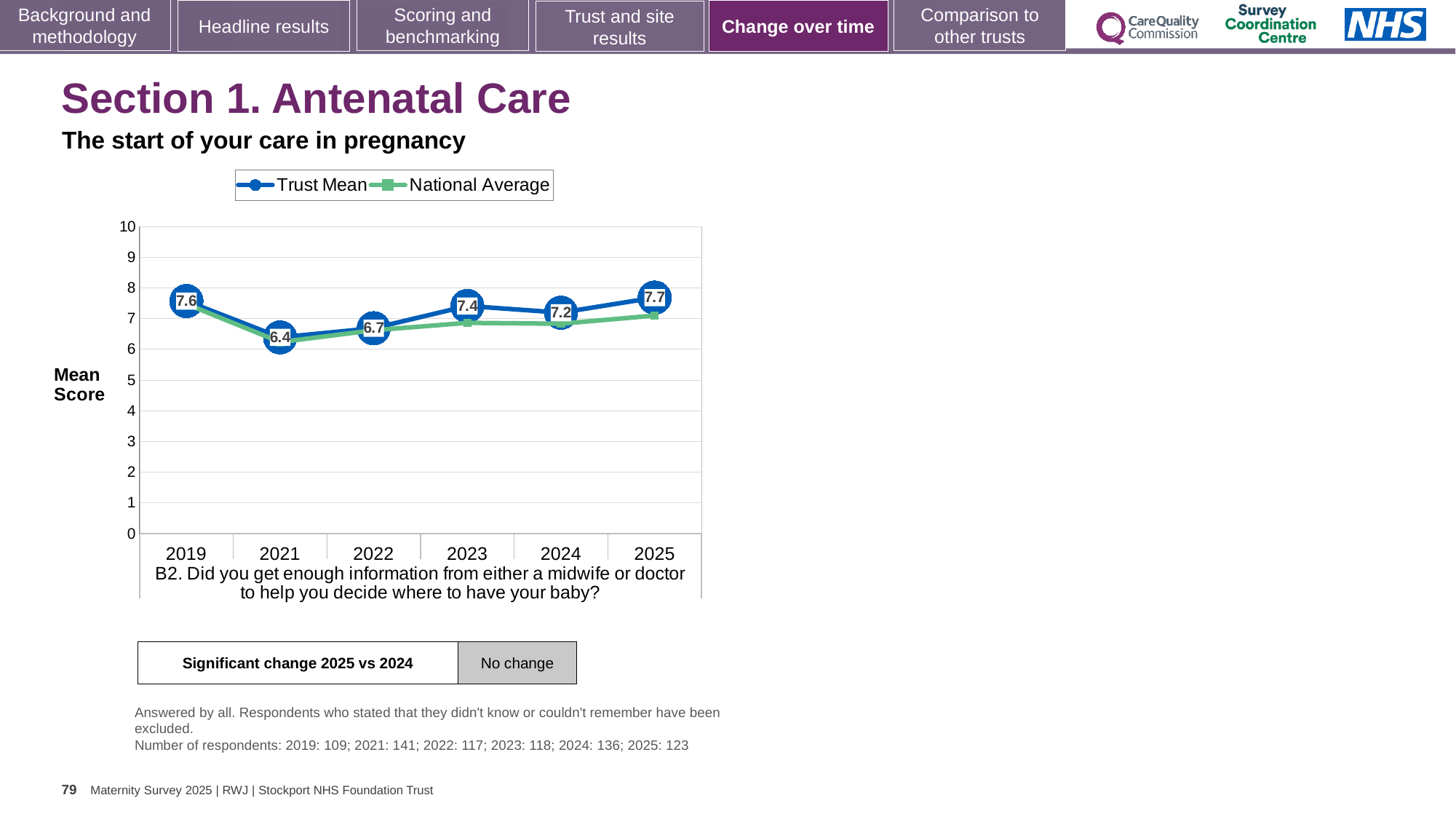
Does the Trust Mean score rise or fall from 2021 to 2023? rise What is the Trust Mean score for 2019? 7.6 What is the Trust Mean score for 2025? 7.7 In which year is the Trust Mean score highest? 2025 What kind of chart is shown? line chart How many years are plotted on the x axis? 6 How many series does the legend list? 2 What is the difference between the Trust Mean scores for 2023 and 2024? 0.2 What is the Trust Mean score for 2022? 6.7 Is the National Average value for 2021 greater or less than 7? less In which year is the Trust Mean score lowest? 2021 Which year has the larger Trust Mean score, 2021 or 2023? 2023